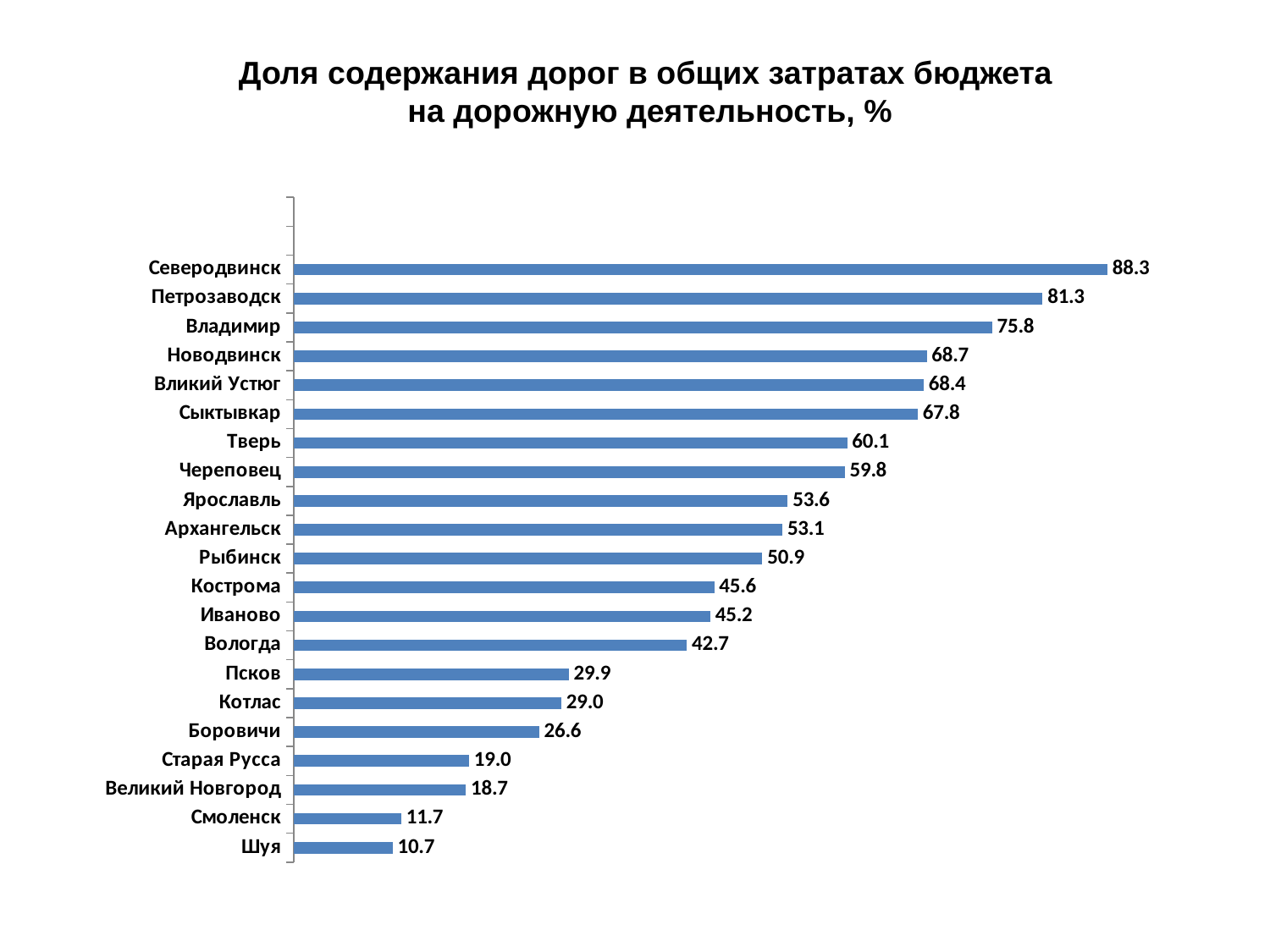
Which city has the highest value? Северодвинск What is the title of the chart? Доля содержания дорог в общих затратах бюджета на дорожную деятельность, % How many cities are shown in the chart? 21 What is the difference between the values for Петрозаводск and Владимир? 5.5 What is the value for Великий Новгород? 18.7 Which is larger, the value for Боровичи or the value for Старая Русса? Боровичи What is the value for Вологда? 42.7 What is the value for Северодвинск? 88.3 What is the difference between the values for Псков and Котлас? 0.9 Which is larger, the value for Тверь or the value for Ярославль? Тверь What kind of chart is shown on the slide? Bar chart Which city has the lowest value? Шуя